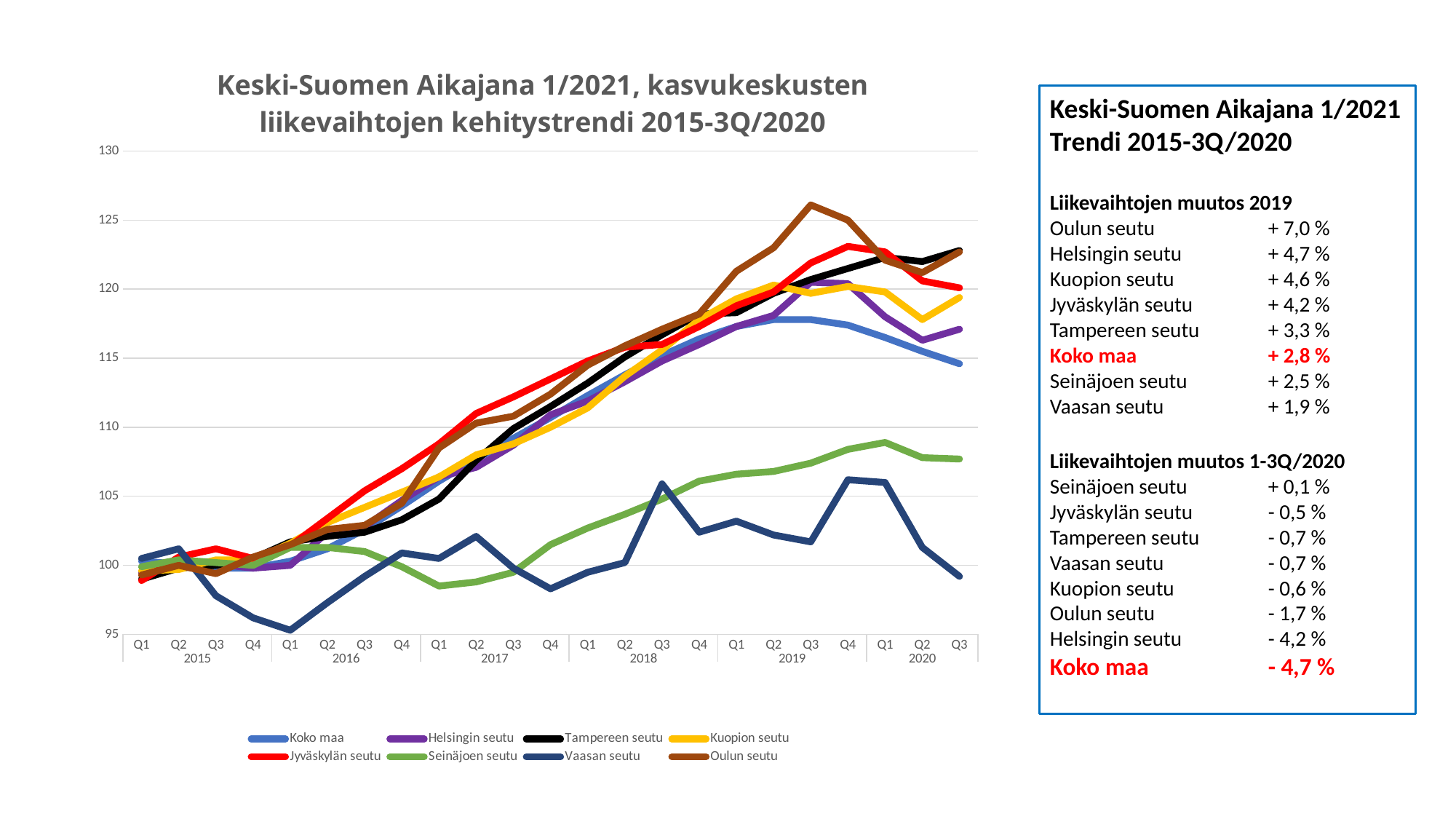
Which series has the highest value at Q3 2019? Oulun seutu What kind of chart is shown on the slide? line chart Which series has the lowest value at Q3 2020? Vaasan seutu What colour is the Tampereen seutu line in the chart? black Which series has the lowest value at Q1 2016? Vaasan seutu Is the value for Oulun seutu at Q3 2019 greater or less than 120? greater How many quarterly points are plotted along the x axis of the chart? 23 Is the value for Seinäjoen seutu at Q3 2020 greater or less than 110? less How many series does the chart legend list? 8 At Q3 2020, which is larger: Seinäjoen seutu or Vaasan seutu? Seinäjoen seutu Is the value for Vaasan seutu at Q1 2016 greater or less than 100? less Does the Tampereen seutu line rise or fall from Q1 2015 to Q4 2018? rises